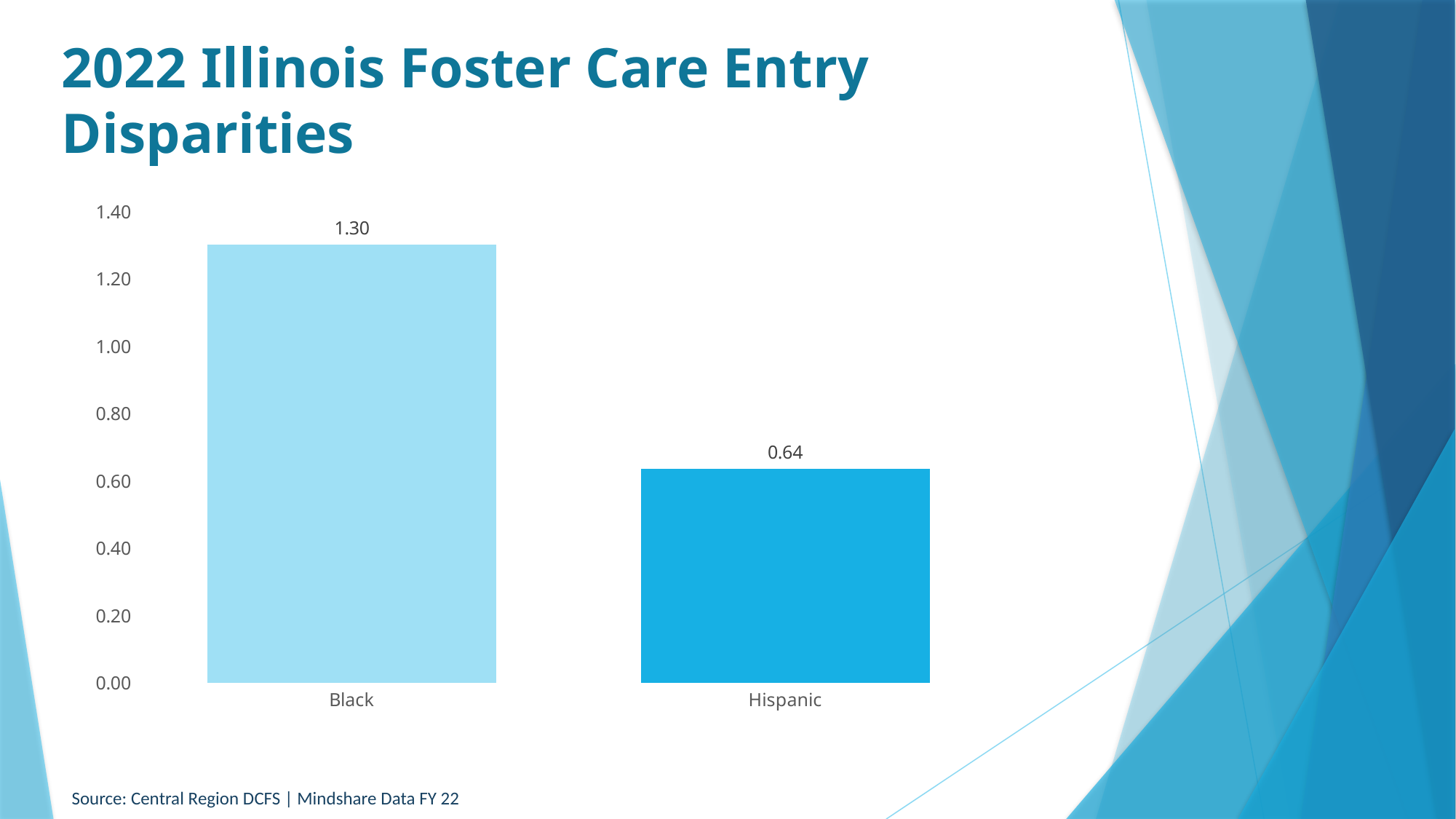
What is the value for Hispanic? 0.64 What is the difference between the values for Black and Hispanic? 0.66 What is the value for Black? 1.30 What is the title of the slide? 2022 Illinois Foster Care Entry Disparities Is the value for Black greater or less than 1.00? greater What is the highest value shown on the vertical axis? 1.40 How many categories are shown in the chart? 2 What kind of chart is shown on the slide? bar chart Is the value for Hispanic greater or less than 0.80? less Which category has the highest value? Black Which category has the lowest value? Hispanic Which is larger, the value for Black or the value for Hispanic? Black